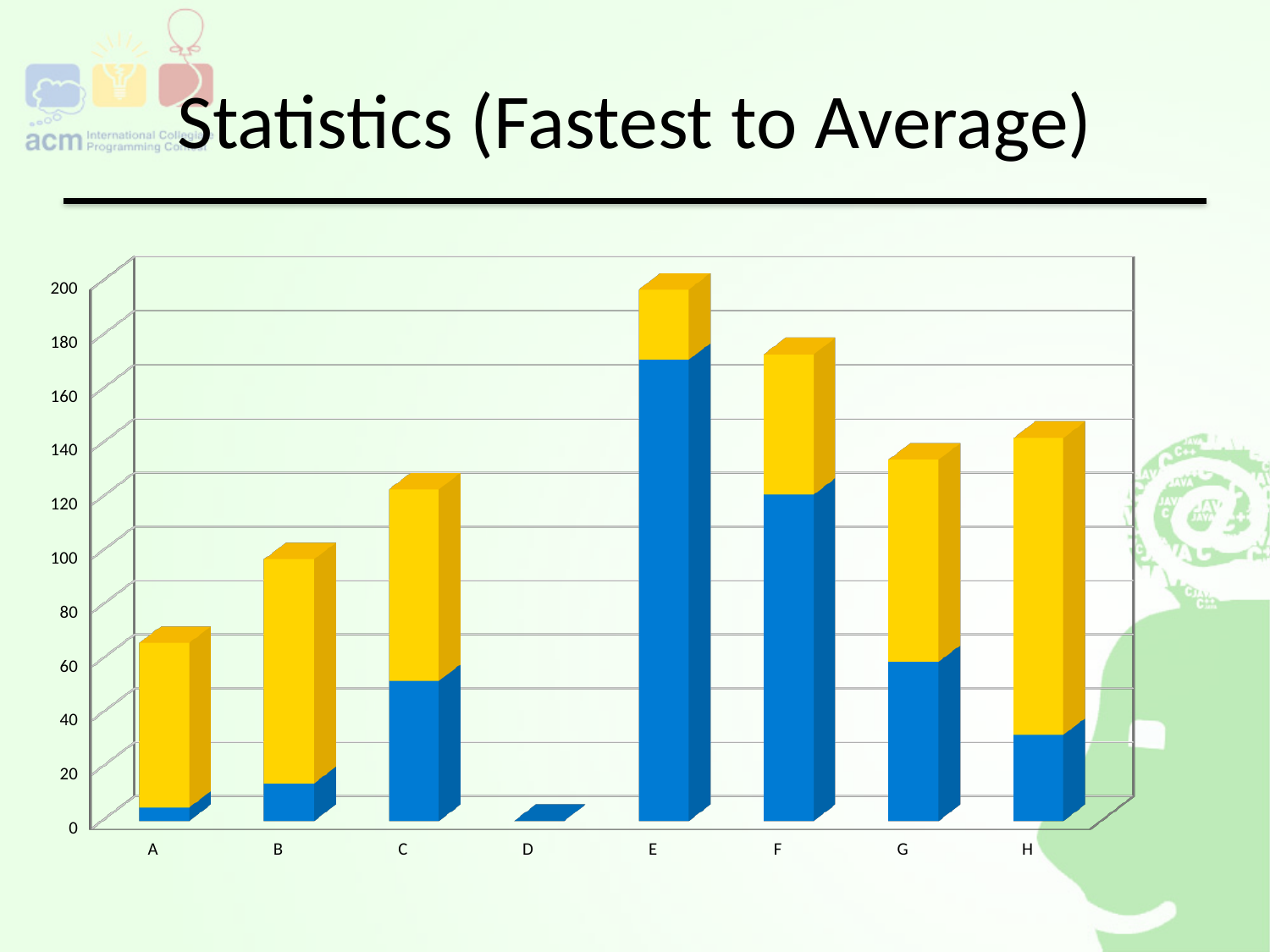
Which has the larger total, A or B? B Is the total value for E greater or less than 180? greater Is the total value for D greater or less than 20? less Which category has the tallest stacked bar? E Is the total value for A greater or less than 80? less Which has the larger total, E or F? E What kind of chart is shown on the slide? bar chart Which category has the shortest stacked bar? D How many categories are shown on the x axis of the chart? 8 What is the title of the slide containing the chart? Statistics (Fastest to Average)